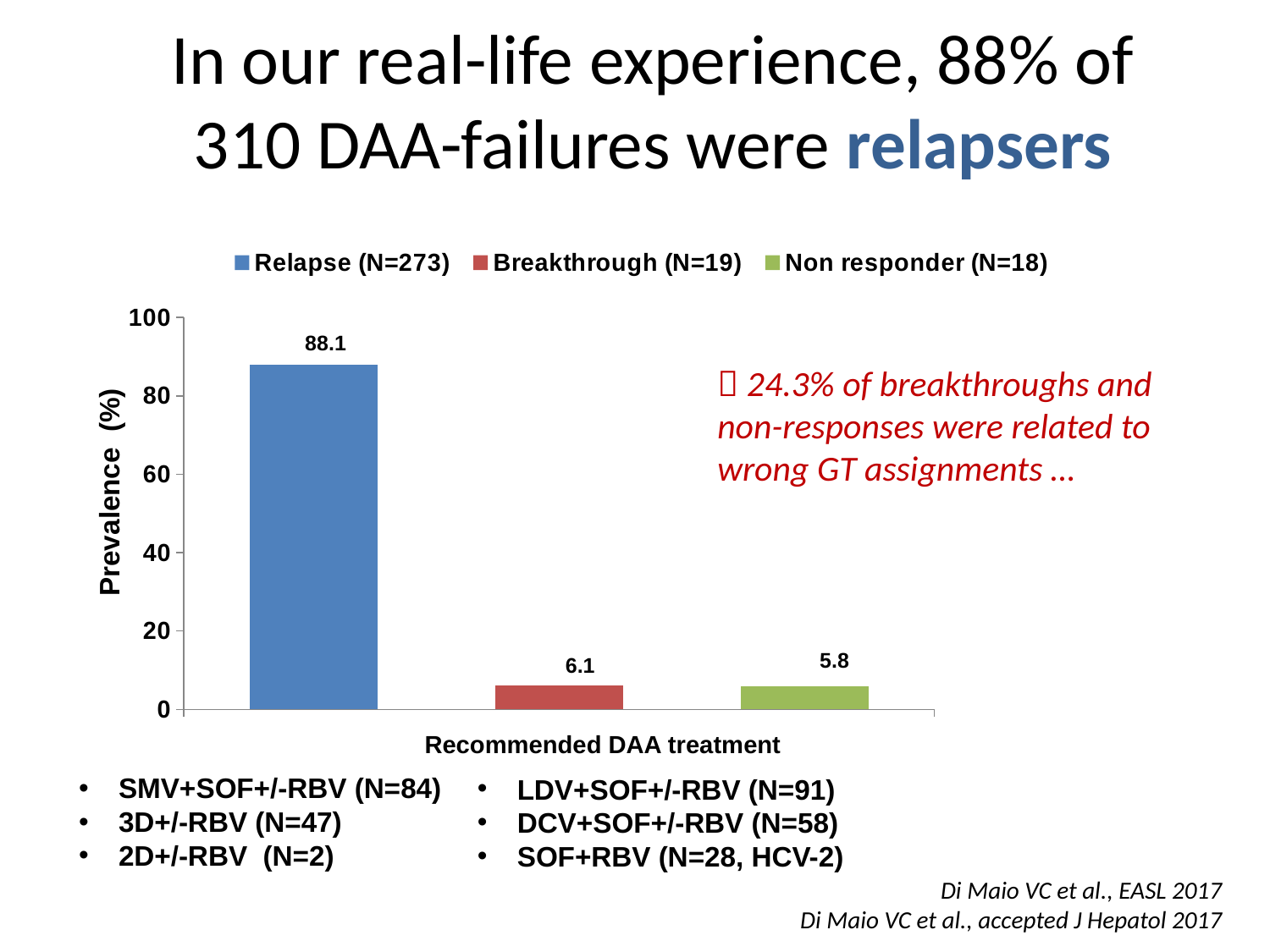
What is the prevalence value shown for Relapse (N=273)? 88.1 What is the difference in prevalence between Relapse (N=273) and Breakthrough (N=19)? 82 Which is larger, the prevalence for Relapse (N=273) or for Non responder (N=18)? Relapse (N=273) What is the label of the y axis? Prevalence (%) How many series does the legend list? 3 Which series has the lowest prevalence? Non responder (N=18) Is the prevalence for Relapse (N=273) greater or less than 80? greater What is the difference in prevalence between Breakthrough (N=19) and Non responder (N=18)? 0.3 What is the prevalence value shown for Breakthrough (N=19)? 6.1 What is the prevalence value shown for Non responder (N=18)? 5.8 What kind of chart is shown on the slide? Bar chart Which series has the highest prevalence? Relapse (N=273)